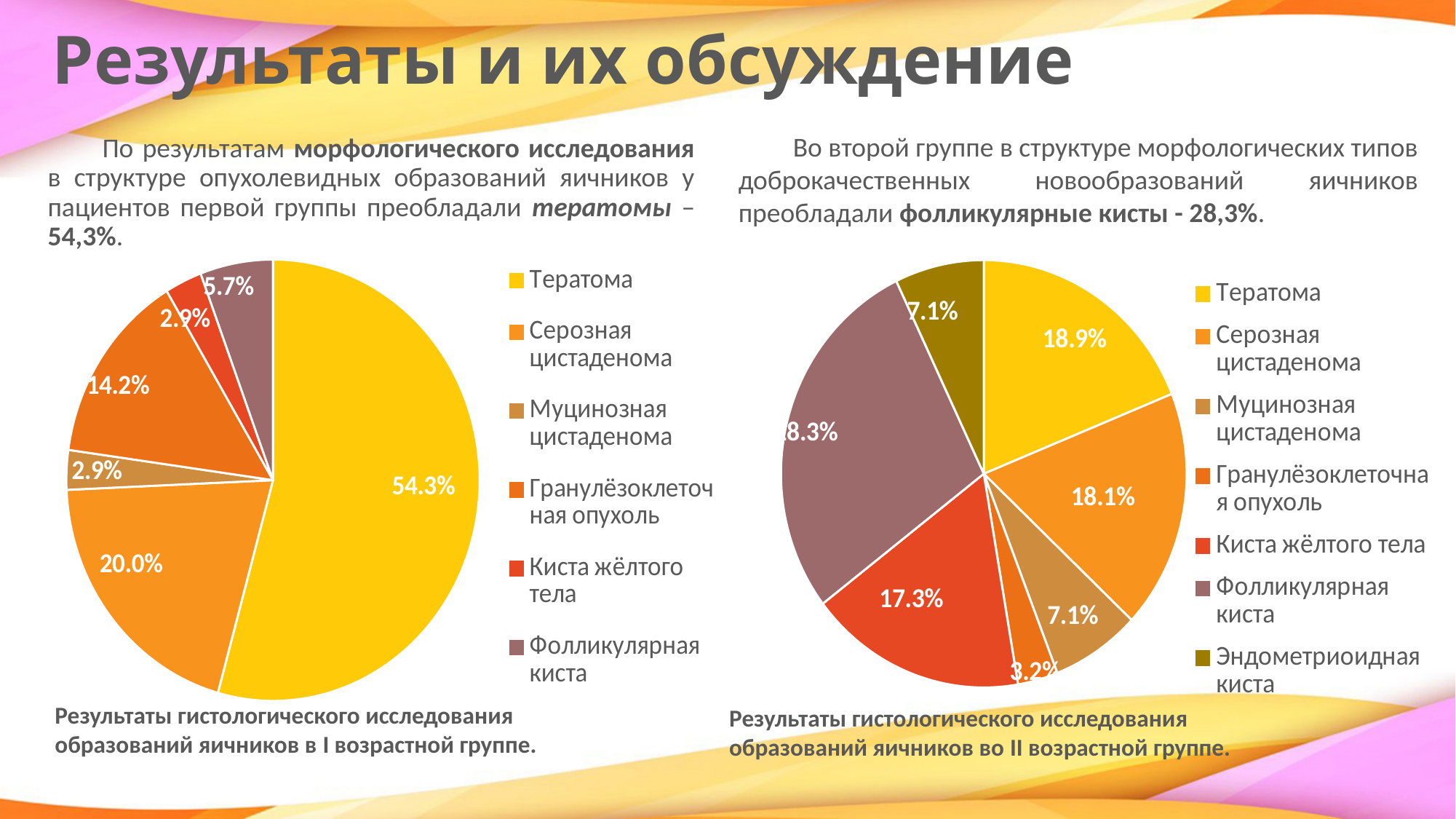
In the left pie chart (I age group), which category has the largest share? Тератома In the right pie chart (II age group), which category has the smallest share? Гранулёзоклеточная опухоль What type of chart is used on the left for the I age group? pie chart How many categories does the legend of the right pie chart (II age group) list? 7 In the left pie chart (I age group), what share is Серозная цистаденома? 20.0% In the left pie chart (I age group), what is the difference between Гранулёзоклеточная опухоль and Фолликулярная киста? 8.5% In the right pie chart (II age group), what share is Фолликулярная киста? 28.3% In the right pie chart (II age group), what share is Киста жёлтого тела? 17.3% Which category appears in the legend of the right pie chart (II age group) but not in the left one? Эндометриоидная киста In the right pie chart (II age group), which is larger: Тератома or Муцинозная цистаденома? Тератома In the left pie chart (I age group), what share is Тератома? 54.3% How many categories does the legend of the left pie chart (I age group) list? 6